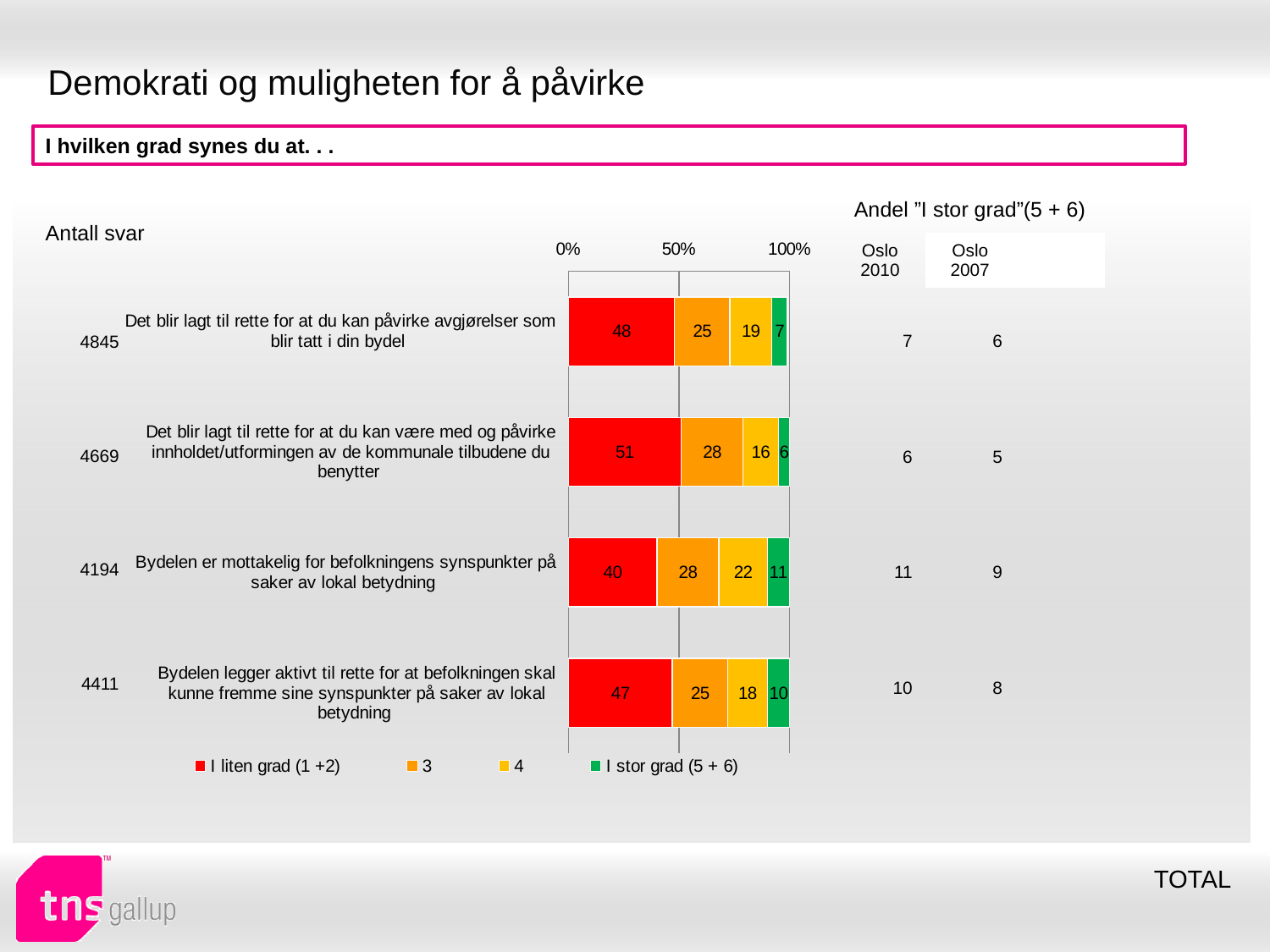
How many statements (categories) are plotted in the chart? 4 What is the value of series "4" for "Det blir lagt til rette for at du kan være med og påvirke innholdet/utformingen av de kommunale tilbudene du benytter"? 16 How many series does the chart legend list? 4 What colour represents the "I stor grad (5 + 6)" series in the chart? green What kind of chart is shown on the slide? stacked bar chart What is the value of "I liten grad (1 +2)" for "Bydelen er mottakelig for befolkningens synspunkter på saker av lokal betydning"? 40 What is the total of the stacked bar for "Bydelen legger aktivt til rette for at befolkningen skal kunne fremme sine synspunkter på saker av lokal betydning"? 100 Which statement has the highest "I liten grad (1 +2)" value? Det blir lagt til rette for at du kan være med og påvirke innholdet/utformingen av de kommunale tilbudene du benytter What is the value of "I stor grad (5 + 6)" for "Det blir lagt til rette for at du kan påvirke avgjørelser som blir tatt i din bydel"? 7 What is the difference between the "I liten grad (1 +2)" values for "Det blir lagt til rette for at du kan være med og påvirke innholdet/utformingen av de kommunale tilbudene du benytter" and "Bydelen er mottakelig for befolkningens synspunkter på saker av lokal betydning"? 11 Which statement has the lowest "I stor grad (5 + 6)" value? Det blir lagt til rette for at du kan være med og påvirke innholdet/utformingen av de kommunale tilbudene du benytter Which is larger: the "I stor grad (5 + 6)" value for "Bydelen er mottakelig for befolkningens synspunkter på saker av lokal betydning" or for "Bydelen legger aktivt til rette for at befolkningen skal kunne fremme sine synspunkter på saker av lokal betydning"? Bydelen er mottakelig for befolkningens synspunkter på saker av lokal betydning